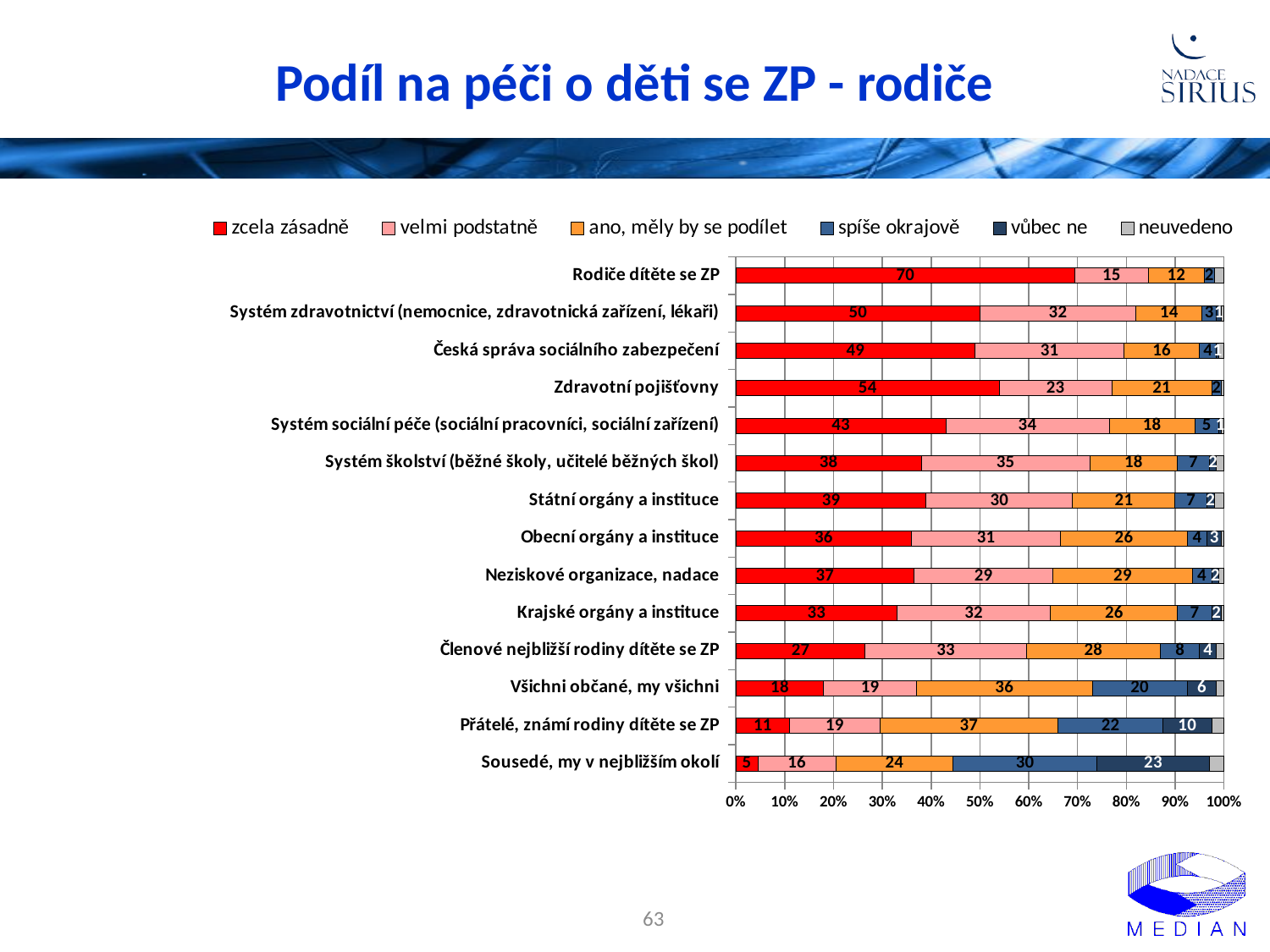
What kind of chart is shown on the slide? Stacked bar chart How many series does the legend list? 6 What is the first entry in the chart legend? zcela zásadně Which has a larger "spíše okrajově" value: "Všichni občané, my všichni" or "Členové nejbližší rodiny dítěte se ZP"? Všichni občané, my všichni What is the value of "vůbec ne" for "Sousedé, my v nejbližším okolí"? 23 Which category has the highest value for "zcela zásadně"? Rodiče dítěte se ZP What is the value of "velmi podstatně" for "Systém školství (běžné školy, učitelé běžných škol)"? 35 What is the difference between the "zcela zásadně" values for "Rodiče dítěte se ZP" and "Zdravotní pojišťovny"? 16 What is the value of "ano, měly by se podílet" for "Přátelé, známí rodiny dítěte se ZP"? 37 How many categories are shown on the chart? 14 Which category has the lowest value for "zcela zásadně"? Sousedé, my v nejbližším okolí What is the value of "zcela zásadně" for "Rodiče dítěte se ZP"? 70